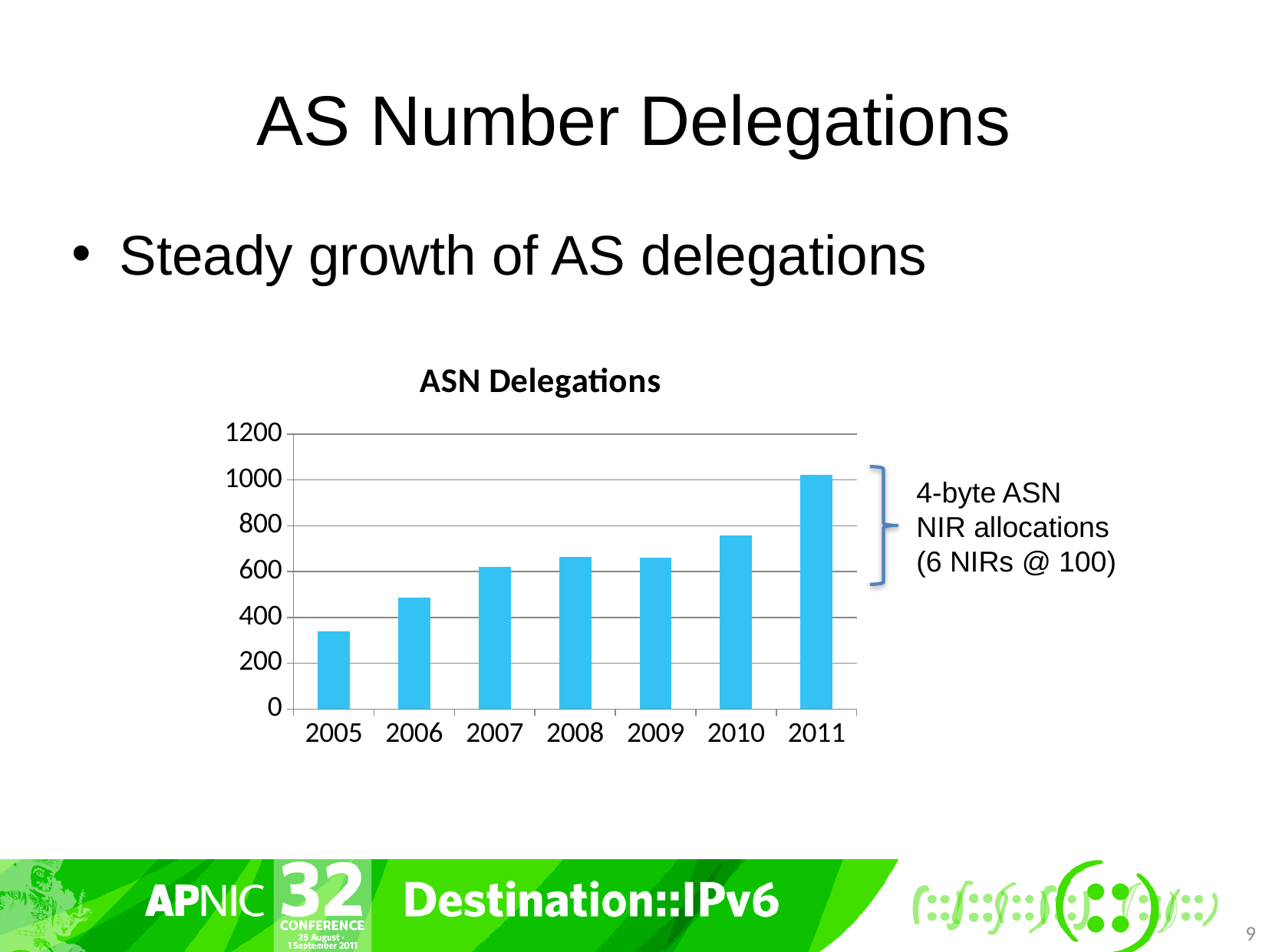
Which year has the lowest number of ASN delegations? 2005 Is the value for 2009 greater or less than 600? greater Do the ASN delegations generally rise or fall from 2005 to 2011? rise What is the title of the chart? ASN Delegations Is the value for 2011 greater or less than 800? greater Is the value for 2005 greater or less than 400? less Which year has more ASN delegations, 2006 or 2010? 2010 How many years are shown on the x axis of the chart? 7 What kind of chart is shown on the slide? bar chart Which year has the highest number of ASN delegations? 2011